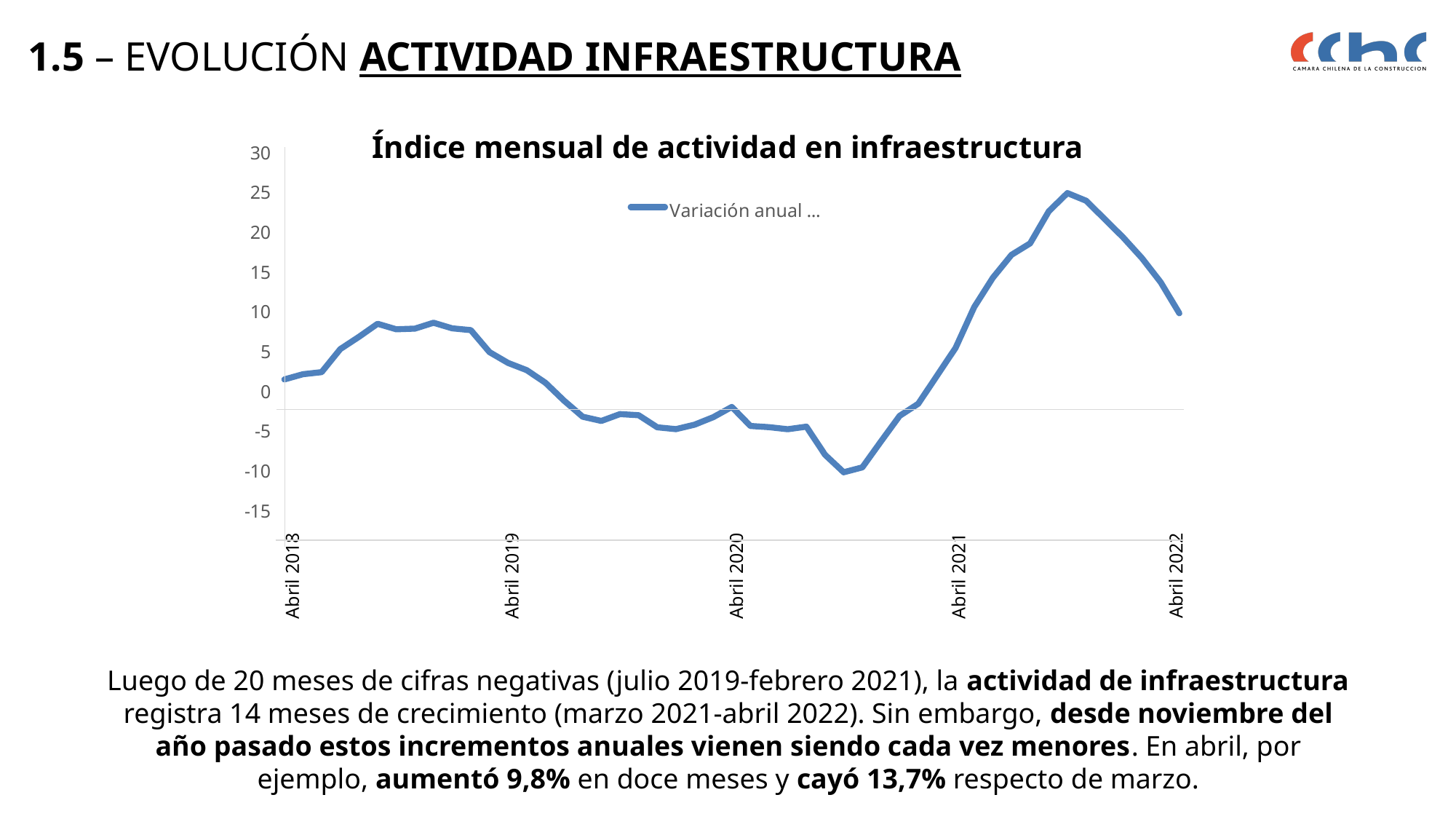
Does the line rise or fall from its peak in late 2021 to Abril 2022? fall Does the line rise or fall between Abril 2021 and its peak later in 2021? rise Is the value for Abril 2022 greater or less than 5? greater Is the lowest point of the line greater or less than -5? less What kind of chart is shown on the slide? line chart How many labelled points are shown on the x axis of the chart? 5 Is the value for Abril 2021 greater or less than 0? greater How many series does the chart legend list? 1 What is the title of the chart? Índice mensual de actividad en infraestructura